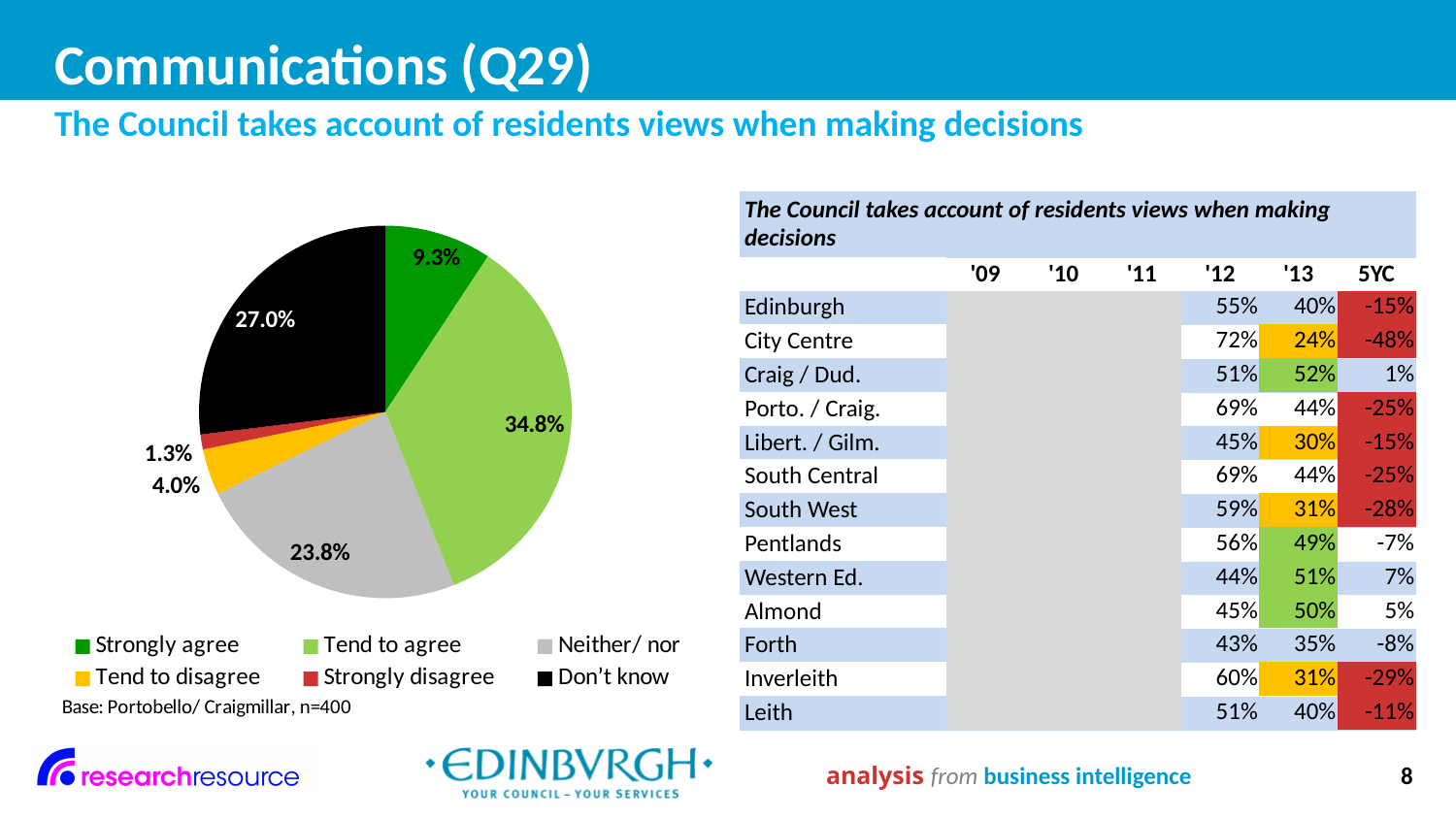
In the pie chart, what share of respondents said 'Tend to agree'? 34.8% How many response categories does the pie chart's legend list? 6 In the pie chart, what share of respondents said 'Neither/ nor'? 23.8% What is the base (sample) stated beneath the pie chart? Portobello/ Craigmillar, n=400 In the pie chart, what share of respondents said 'Strongly disagree'? 1.3% Which response has the largest slice in the pie chart? Tend to agree In the pie chart, what is the difference between the 'Tend to agree' and 'Don't know' shares? 7.8% What kind of chart is shown on the left of the slide? Pie chart In the pie chart, what share of respondents said 'Strongly agree'? 9.3% Which response has the smallest slice in the pie chart? Strongly disagree In the pie chart, which is larger: 'Neither/ nor' or 'Don't know'? Don't know In the pie chart, what share of respondents said 'Don't know'? 27.0%